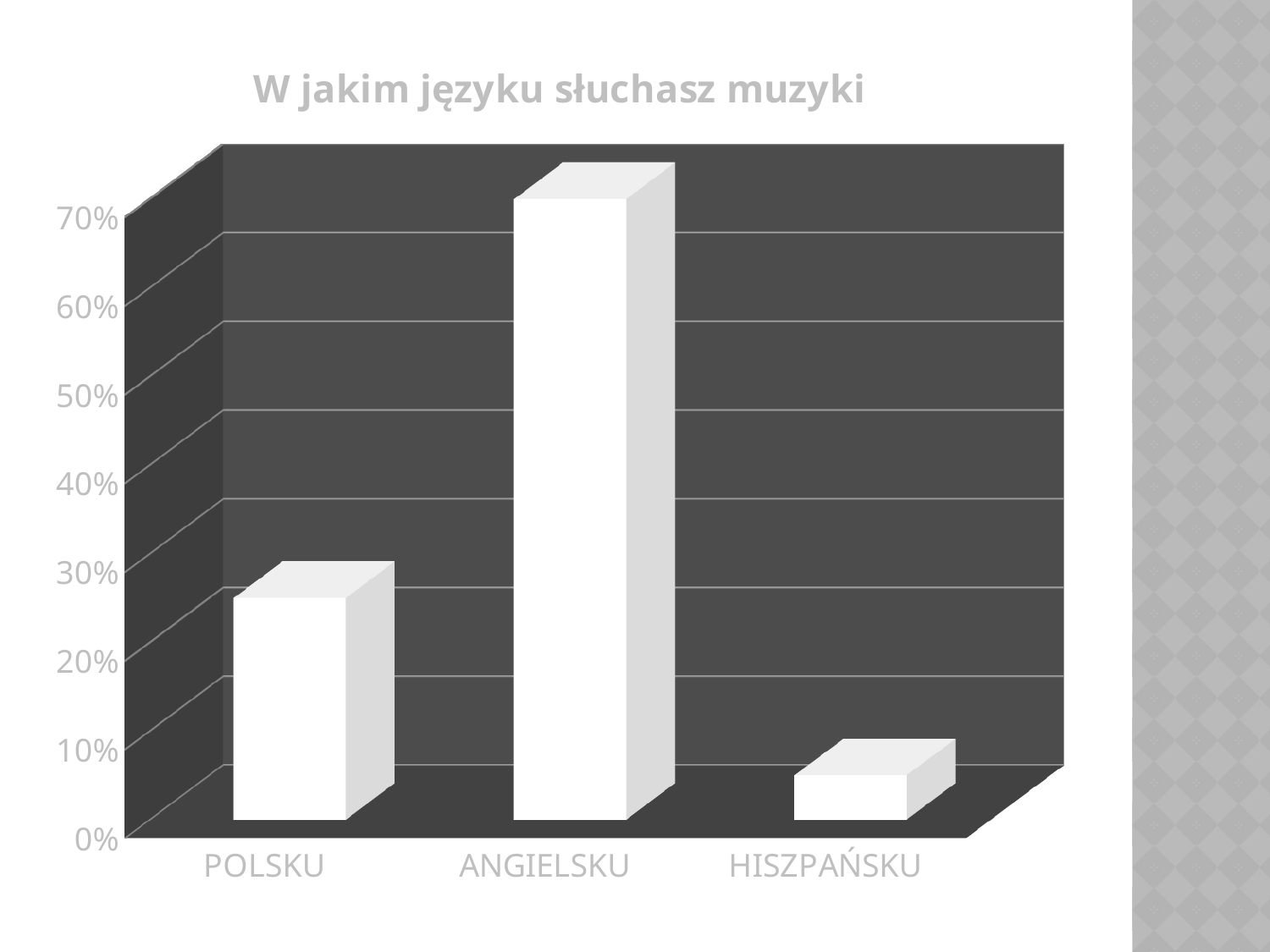
Is the value for HISZPAŃSKU greater or less than 20%? less What is the label of the category listed first on the x axis? POLSKU Is the value for POLSKU greater or less than 30%? less Which is larger, the value for POLSKU or the value for HISZPAŃSKU? POLSKU Is the value for ANGIELSKU greater or less than 60%? greater How many categories are shown on the x axis? 3 Which category has the highest value? ANGIELSKU What kind of chart is shown on the slide? bar chart Which category has the lowest value? HISZPAŃSKU Which is larger, the value for ANGIELSKU or the value for POLSKU? ANGIELSKU What is the title of the chart? W jakim języku słuchasz muzyki